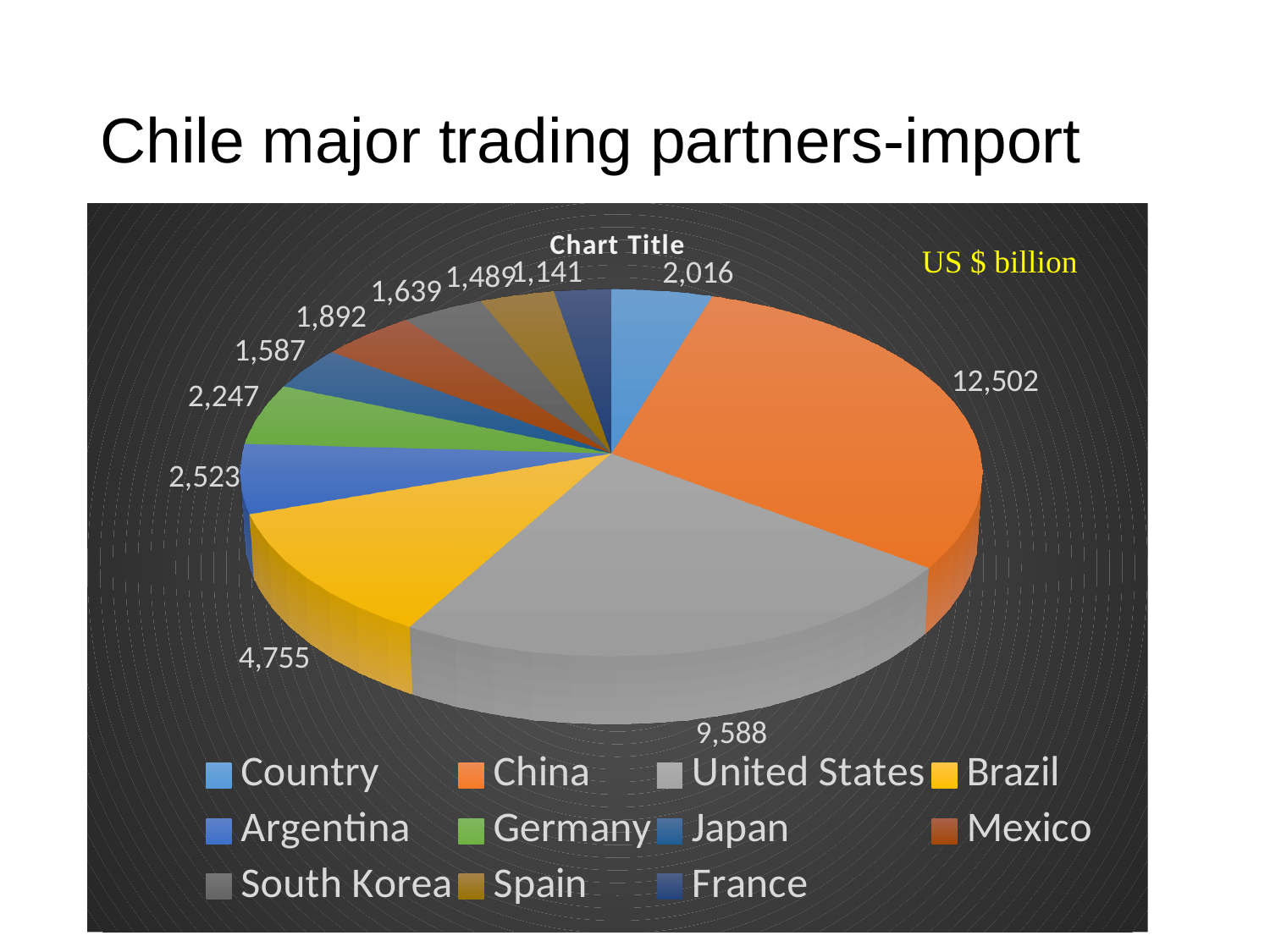
What is the value for United States? 9,588 How many slices does the pie chart have? 11 What kind of chart is shown on the slide? Pie chart What is the value for China? 12,502 What unit is shown in the top right corner of the chart? US $ billion Which category has the largest slice? China What is the value for Brazil? 4,755 What is the difference between the values for China and United States? 2,914 What is the value for Mexico? 1,892 What is the difference between the values for Brazil and Argentina? 2,232 Which is larger, the value for Argentina or the value for Germany? Argentina Which category has the smallest slice? France